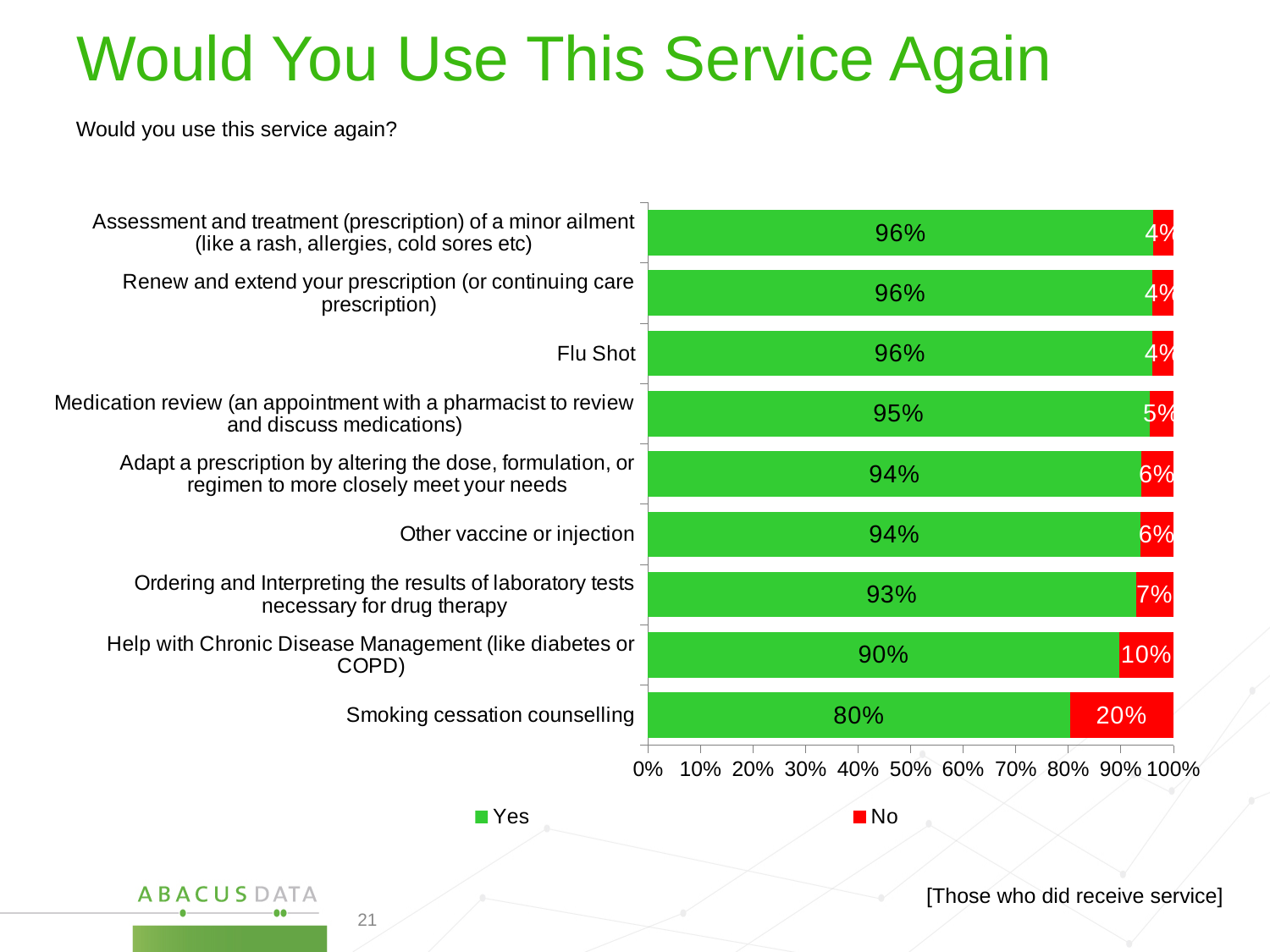
Which category has the lowest Yes value? Smoking cessation counselling What is the Yes value for Flu Shot? 96% What is the difference between the Yes values for Flu Shot and Smoking cessation counselling? 16% What is the total of the Yes and No values for Medication review (an appointment with a pharmacist to review and discuss medications)? 100% Which category has the highest No value? Smoking cessation counselling How many series does the legend list? 2 What percentage of respondents said Yes for Smoking cessation counselling? 80% What kind of chart is shown on the slide? Stacked bar chart How many categories are shown in the chart? 9 What percentage of respondents said No for Help with Chronic Disease Management (like diabetes or COPD)? 10% What is the No value for Ordering and Interpreting the results of laboratory tests necessary for drug therapy? 7% Which has a larger Yes value, Other vaccine or injection or Help with Chronic Disease Management (like diabetes or COPD)? Other vaccine or injection